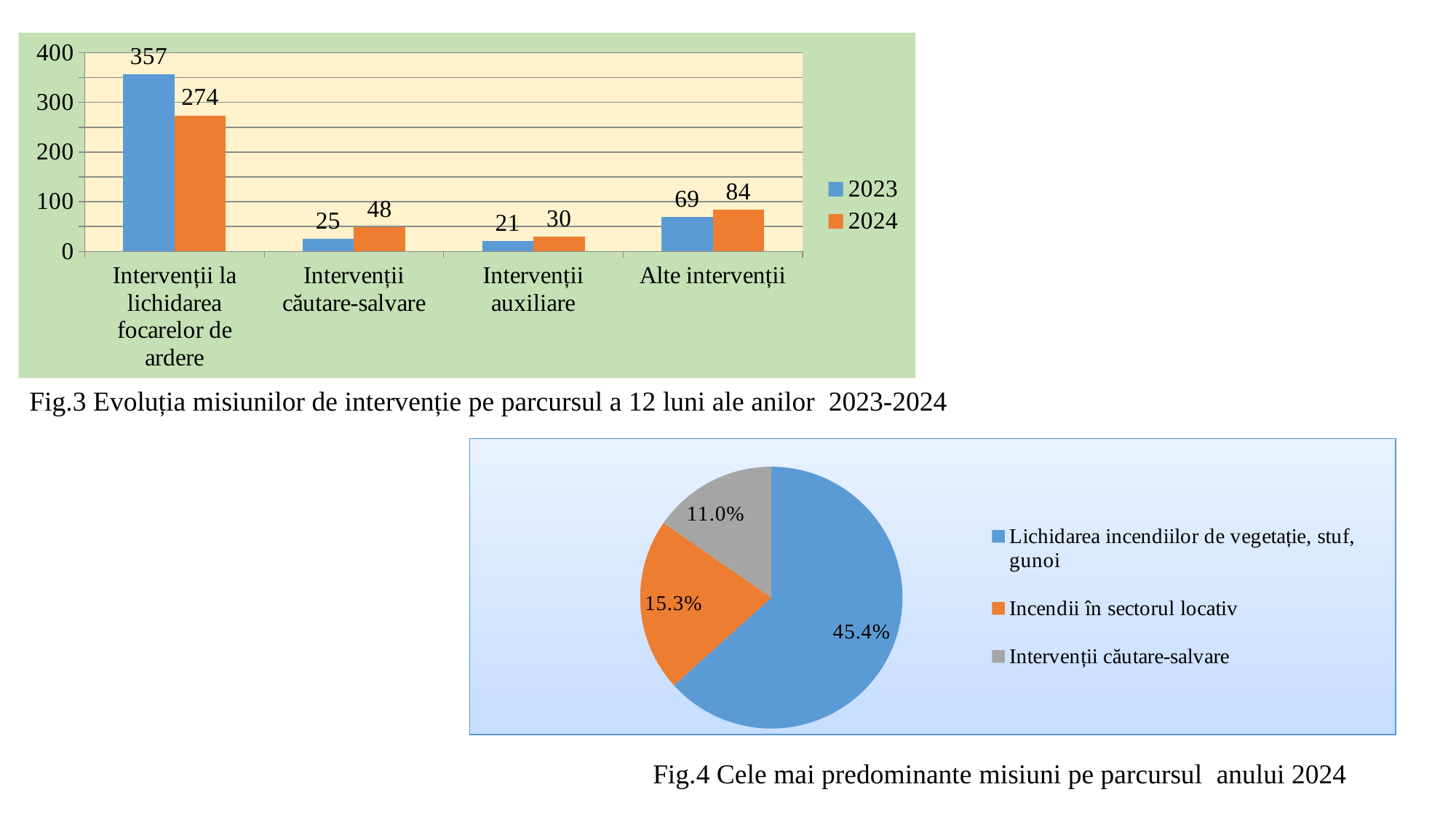
How many categories are shown on the x axis of the Fig.3 bar chart? 4 In the Fig.3 bar chart, what is the 2024 value for Intervenții căutare-salvare? 48 In the Fig.3 bar chart, what is the 2024 value for Alte intervenții? 84 In the Fig.4 pie chart, which slice is the smallest? Intervenții căutare-salvare How many series does the legend of the Fig.3 bar chart list? 2 In the Fig.3 bar chart, what is the difference between the 2023 and 2024 values for Intervenții la lichidarea focarelor de ardere? 83 What kind of chart is Fig.4? Pie chart In the Fig.3 bar chart, which category has the highest 2024 value? Intervenții la lichidarea focarelor de ardere In the Fig.3 bar chart, what is the 2023 value for Intervenții la lichidarea focarelor de ardere? 357 In the Fig.3 bar chart, which is larger for Intervenții auxiliare: the 2023 value or the 2024 value? 2024 In the Fig.3 bar chart, which category has the lowest 2023 value? Intervenții auxiliare In the Fig.4 pie chart, what share does Incendii în sectorul locativ have? 15.3%